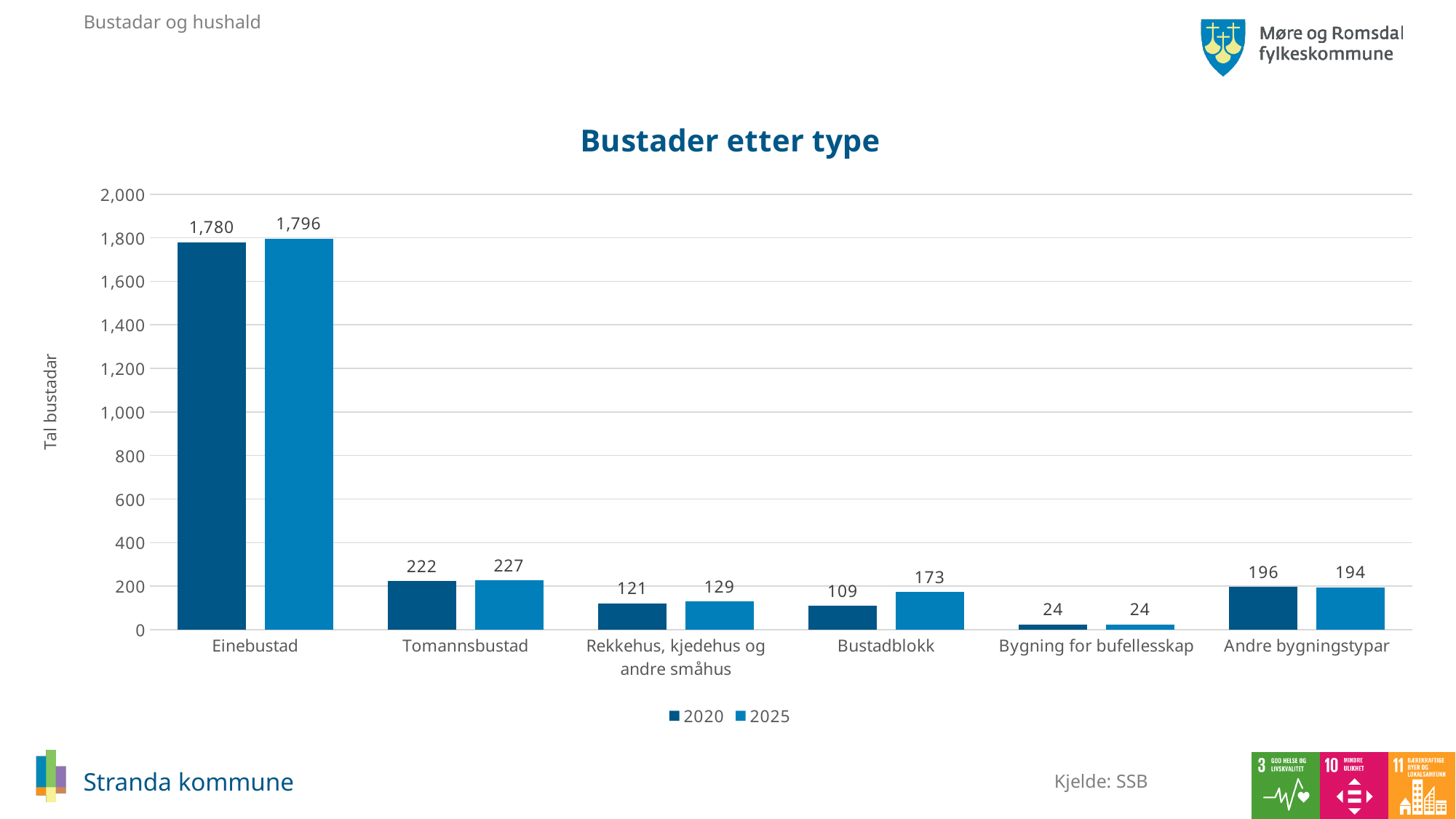
Which is larger for Andre bygningstypar: the 2020 value or the 2025 value? 2020 Is the value for Tomannsbustad in 2025 greater or less than 200? greater How many series does the legend list? 2 How many categories are shown on the x axis? 6 Which category has the lowest value in 2025? Bygning for bufellesskap What is the value for Einebustad in 2025? 1,796 What is the title of the chart? Bustader etter type What is the value for Bustadblokk in 2020? 109 What kind of chart is shown on the slide? Bar chart Which category has the highest value in 2020? Einebustad What is the difference between the 2025 and 2020 values for Bustadblokk? 64 What is the value for Bygning for bufellesskap in 2025? 24